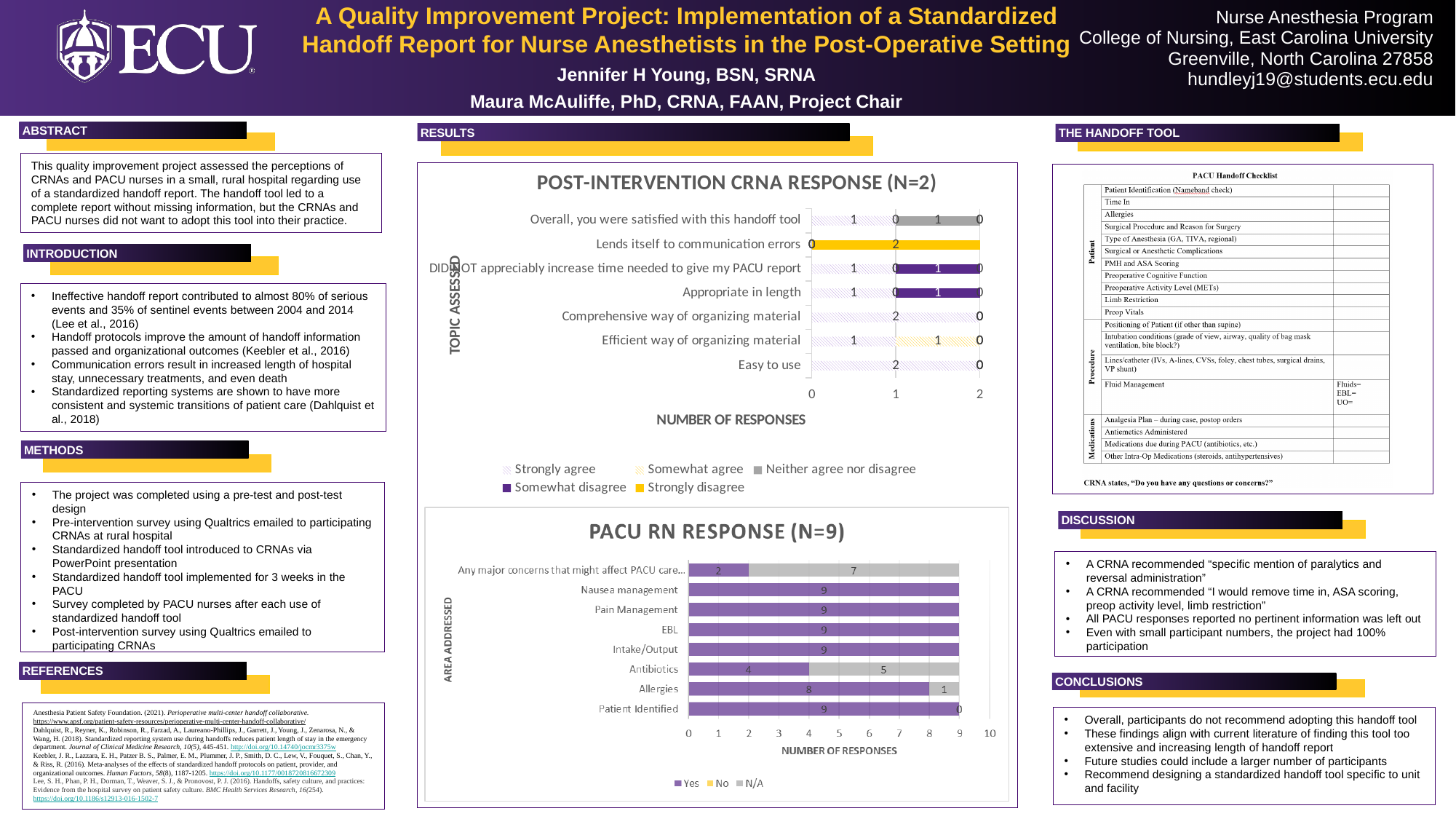
In the PACU RN RESPONSE (N=9) chart, how many areas are listed on the vertical axis? 8 What is the label of the horizontal axis in the POST-INTERVENTION CRNA RESPONSE (N=2) chart? NUMBER OF RESPONSES What type of chart is the POST-INTERVENTION CRNA RESPONSE (N=2) chart? Stacked bar chart In the PACU RN RESPONSE (N=9) chart, how many 'Yes' responses were recorded for Antibiotics? 4 In the POST-INTERVENTION CRNA RESPONSE (N=2) chart, how many 'Strongly agree' responses were given for 'Easy to use'? 2 In the PACU RN RESPONSE (N=9) chart, what is the difference between the 'Yes' responses for Nausea management and the 'Yes' responses for Antibiotics? 5 In the POST-INTERVENTION CRNA RESPONSE (N=2) chart, how many 'Strongly disagree' responses were given for 'Lends itself to communication errors'? 2 In the PACU RN RESPONSE (N=9) chart, how many series does the legend list? 3 In the PACU RN RESPONSE (N=9) chart, how many 'N/A' responses were recorded for 'Any major concerns that might affect PACU care...'? 7 In the PACU RN RESPONSE (N=9) chart, how many 'Yes' responses were recorded for Allergies? 8 In the PACU RN RESPONSE (N=9) chart, which area has the fewest 'Yes' responses? Any major concerns that might affect PACU care... In the POST-INTERVENTION CRNA RESPONSE (N=2) chart, how many series does the legend list? 5